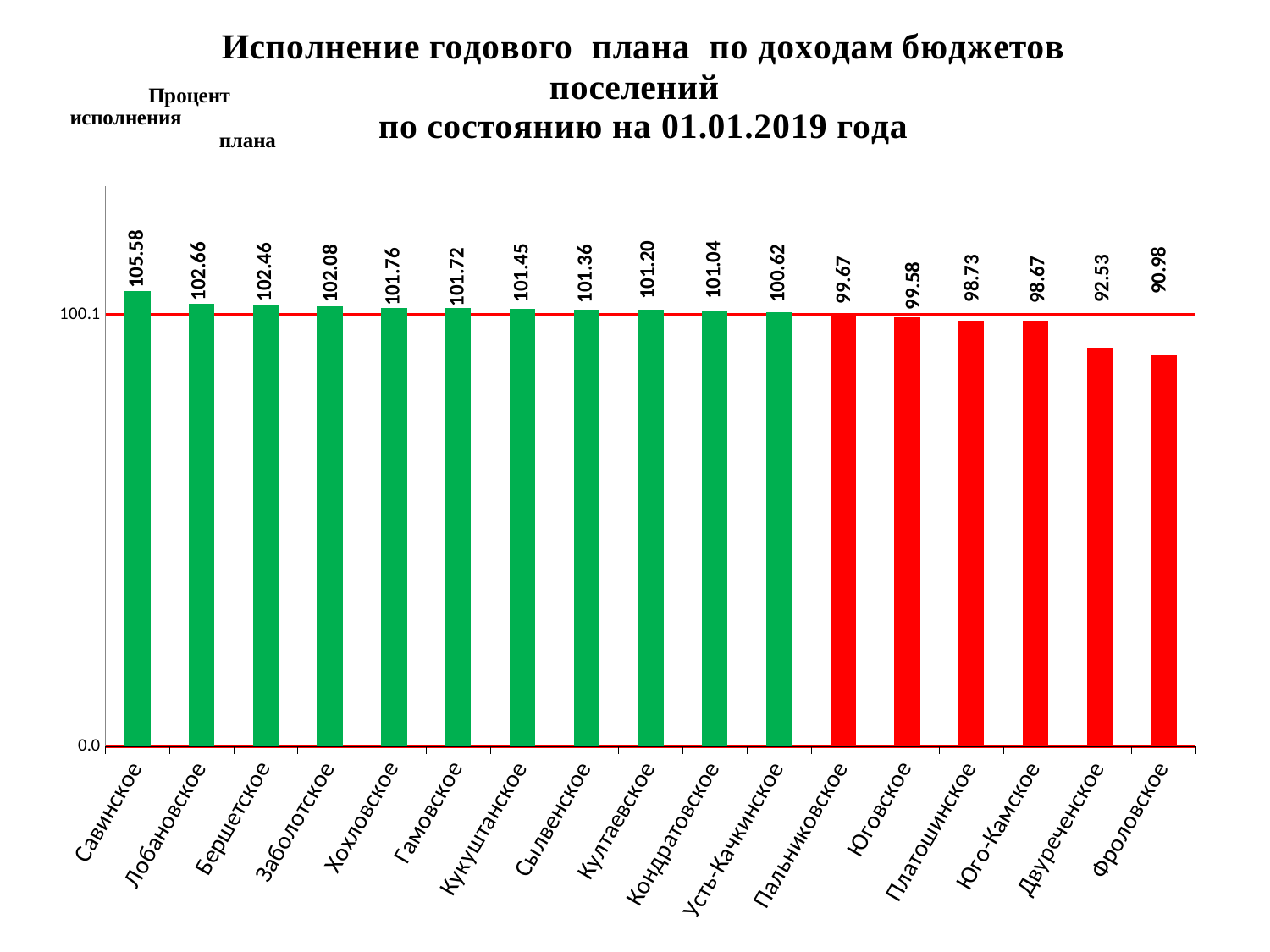
What is the value for Фроловское? 90.98 What is the value for Савинское? 105.58 Do the values rise or fall from left to right along the x axis? Fall What colour are the bars for categories with values below 100? Red Which is larger, the value for Двуреченское or the value for Фроловское? Двуреченское What is the value for Усть-Качкинское? 100.62 Which category has the highest value? Савинское What is the difference between the values for Савинское and Фроловское? 14.60 What kind of chart is shown on the slide? Bar chart How many categories are shown on the x axis? 17 What is the value for Платошинское? 98.73 Which category has the lowest value? Фроловское